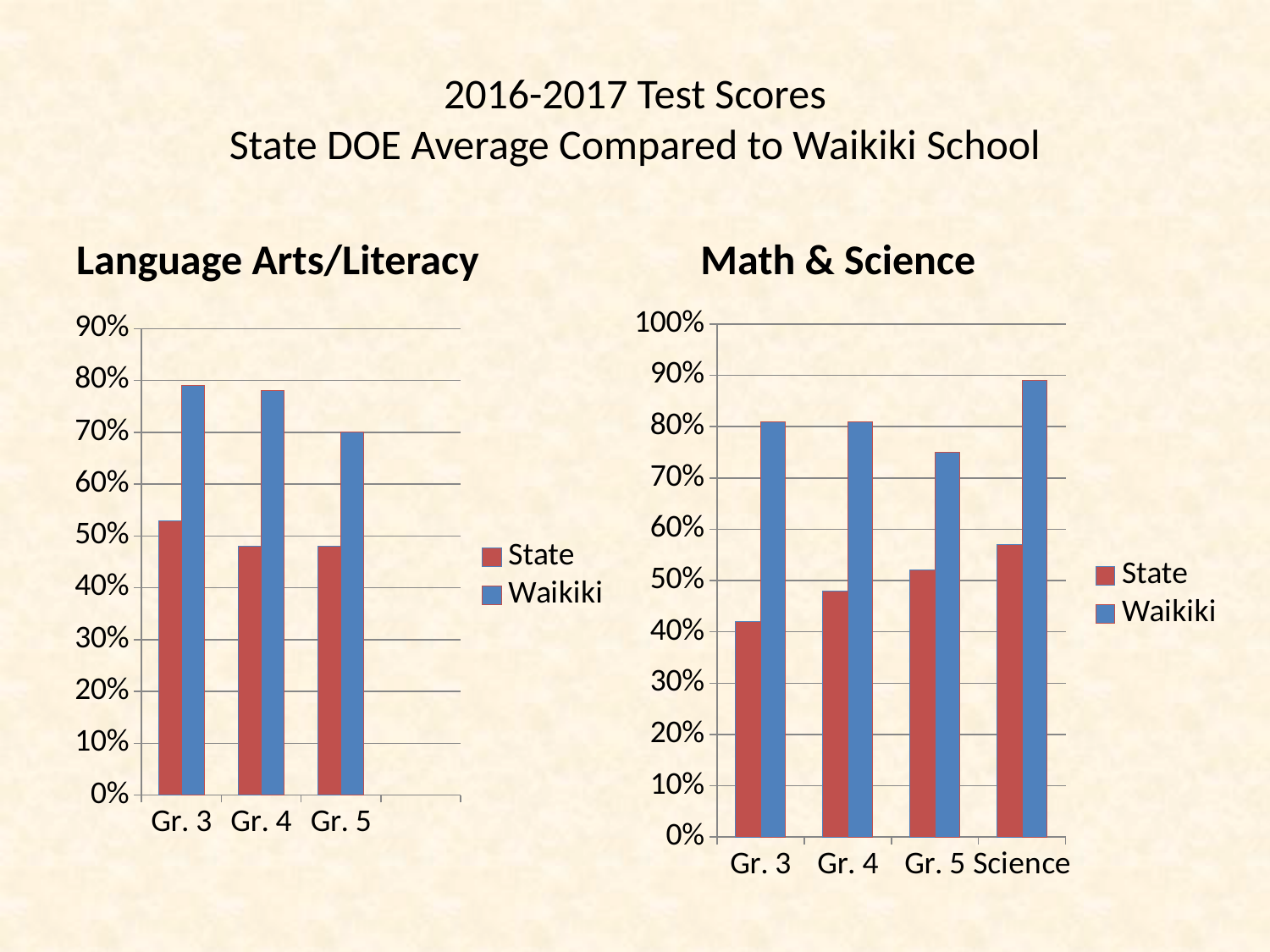
In the Language Arts/Literacy chart, which is larger for Gr. 3, State or Waikiki? Waikiki What are the two legend entries in the Math & Science chart? State and Waikiki In the Math & Science chart, is the State value for Gr. 3 greater or less than 50%? less In the Math & Science chart, is the Waikiki value for Science greater or less than 80%? greater In the Language Arts/Literacy chart, is the State value for Gr. 3 greater or less than 50%? greater What kind of chart is the Language Arts/Literacy chart? bar chart How many categories are shown on the x axis of the Math & Science chart? 4 In the Math & Science chart, which category has the lowest State value? Gr. 3 How many series does the legend of the Language Arts/Literacy chart list? 2 In the Math & Science chart, do the State values rise or fall from Gr. 3 to Science along the x axis? rise In the Math & Science chart, which category has the highest Waikiki value? Science